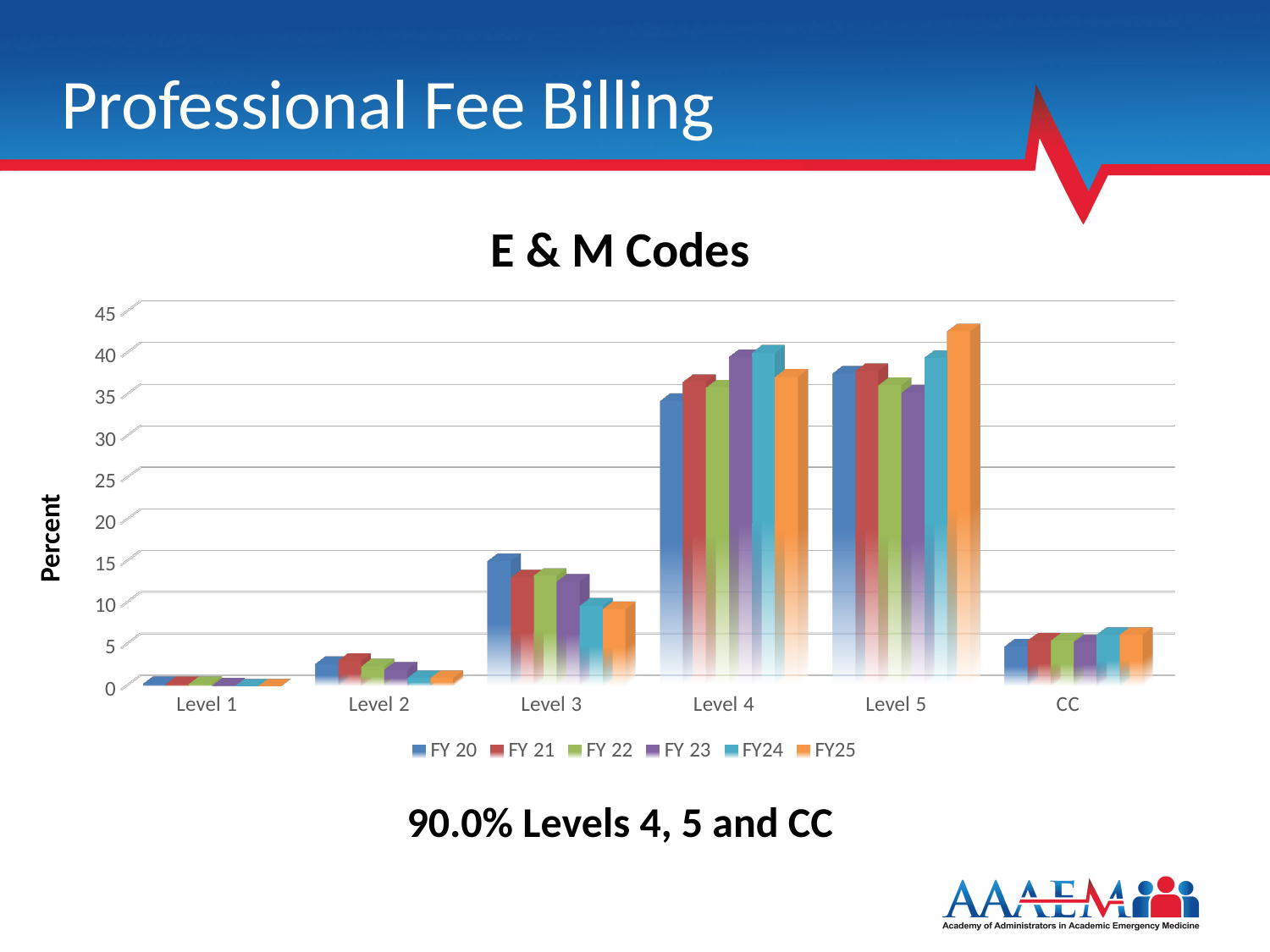
Do the values for Level 3 rise or fall from FY 20 to FY25? fall How many categories are shown on the x axis? 6 What is the label of the vertical axis? Percent Is the value for FY 20 at Level 3 greater or less than 10? greater What type of chart is shown on the slide? bar chart How many series does the legend list? 6 Is the value for FY 20 at Level 2 greater or less than 5? less For FY25, which is larger: the value for Level 4 or the value for Level 5? Level 5 What is the title of the chart? E & M Codes Is the value for FY25 at Level 5 greater or less than 40? greater Which category has the lowest values across all fiscal years? Level 1 Which category has the highest value for FY25? Level 5